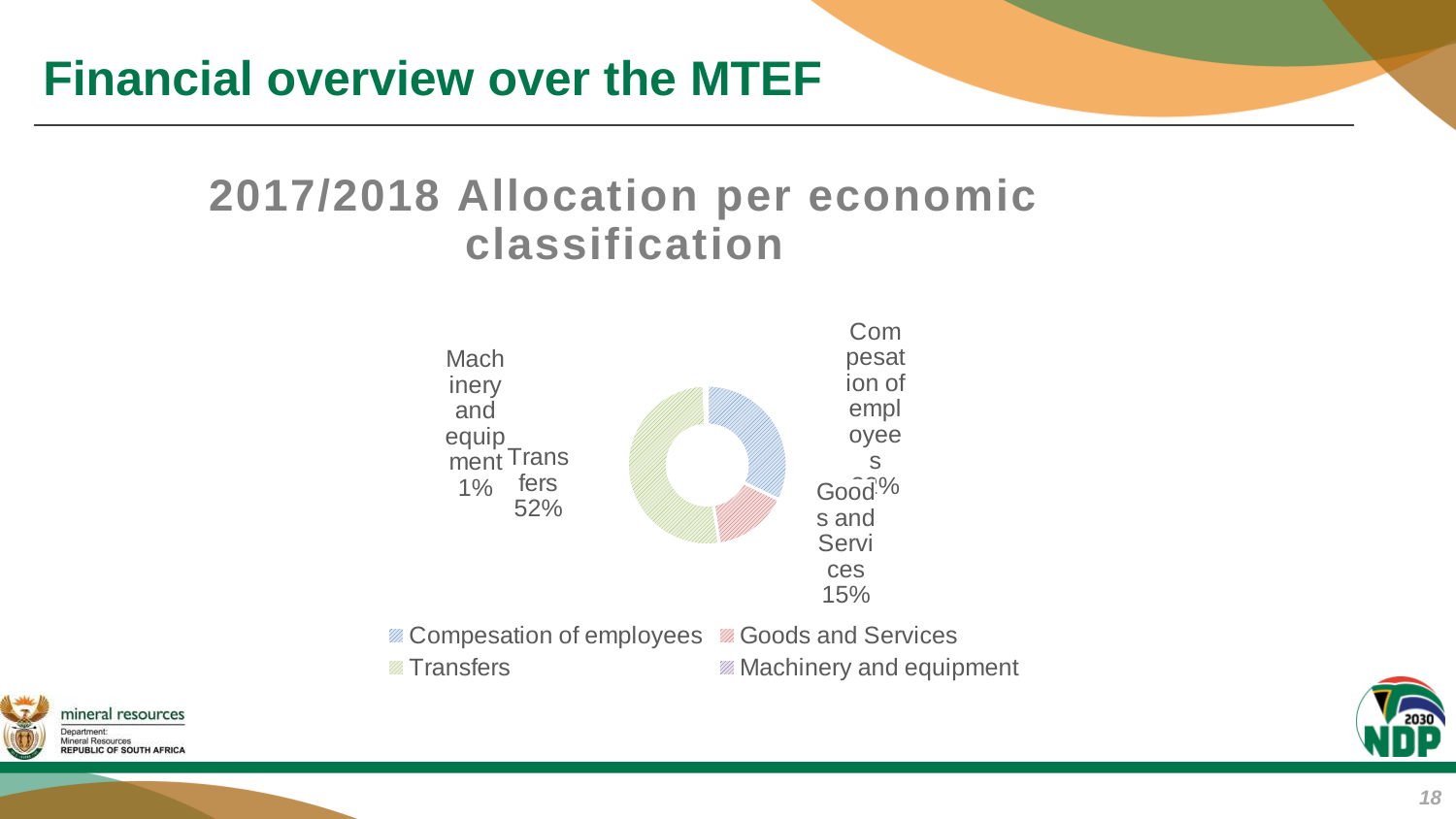
What is the title of the chart? 2017/2018 Allocation per economic classification How many percentage points larger is the Transfers share than the Goods and Services share? 37% How many entries does the legend list? 4 Which economic classification has the largest share of the allocation? Transfers What share of the 2017/2018 allocation goes to Goods and Services? 15% Which legend entry appears first in the legend? Compesation of employees How many economic classifications are shown in the chart? 4 What kind of chart is shown on the slide? Doughnut (pie) chart What share of the 2017/2018 allocation goes to Transfers? 52% Which is larger, the share for Goods and Services or the share for Machinery and equipment? Goods and Services Which economic classification has the smallest share of the allocation? Machinery and equipment What share of the 2017/2018 allocation goes to Machinery and equipment? 1%